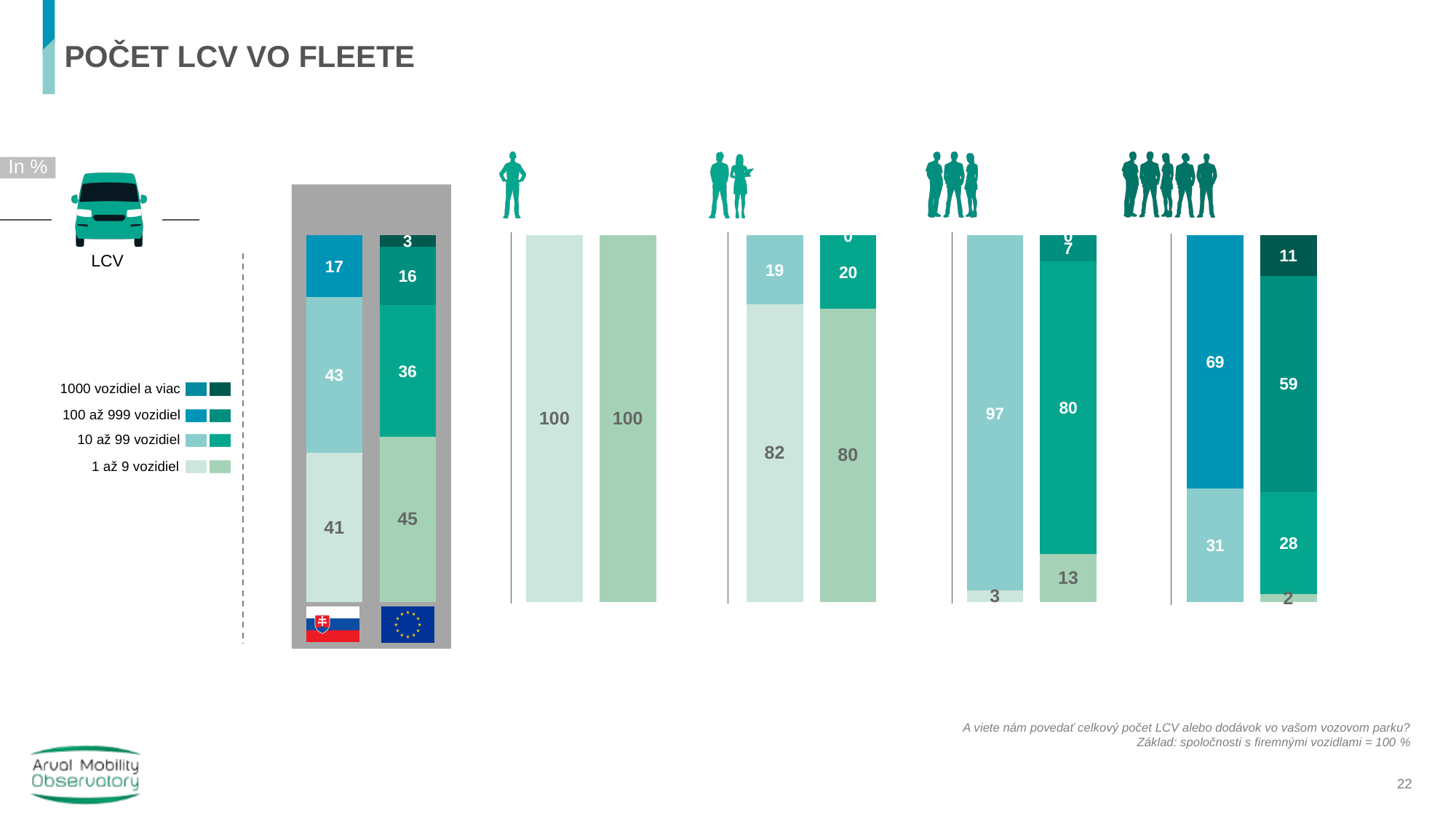
In the leftmost chart (grey box with the Slovak and EU flags), what is the value of the '1 až 9 vozidiel' segment for the Slovak bar? 41 In the leftmost chart (grey box with the flags), which segment of the Slovak bar is the largest? 10 až 99 vozidiel In the leftmost chart (grey box with the flags), what is the value of the '10 až 99 vozidiel' segment for the EU bar? 36 In the chart under the three-person icon, what is the value of the '1 až 9 vozidiel' segment for the EU bar? 13 In the chart under the three-person icon, what is the difference between the '10 až 99 vozidiel' segment of the Slovak bar and that of the EU bar? 17 In the chart under the two-person icon, which is larger: the '1 až 9 vozidiel' segment of the Slovak bar or of the EU bar? Slovak bar In the chart under the single-person icon, what value is shown for the Slovak bar? 100 In the leftmost chart (grey box with the flags), what is the value of the '1000 vozidiel a viac' segment for the EU bar? 3 In the rightmost chart (five-person icon), what is the value of the '100 až 999 vozidiel' segment for the EU bar? 59 In the chart under the two-person icon, what is the value of the '10 až 99 vozidiel' segment for the Slovak bar? 19 How many fleet-size categories does the legend list? 4 In the leftmost chart (grey box with the flags), what is the difference between the '100 až 999 vozidiel' segment of the Slovak bar and that of the EU bar? 1